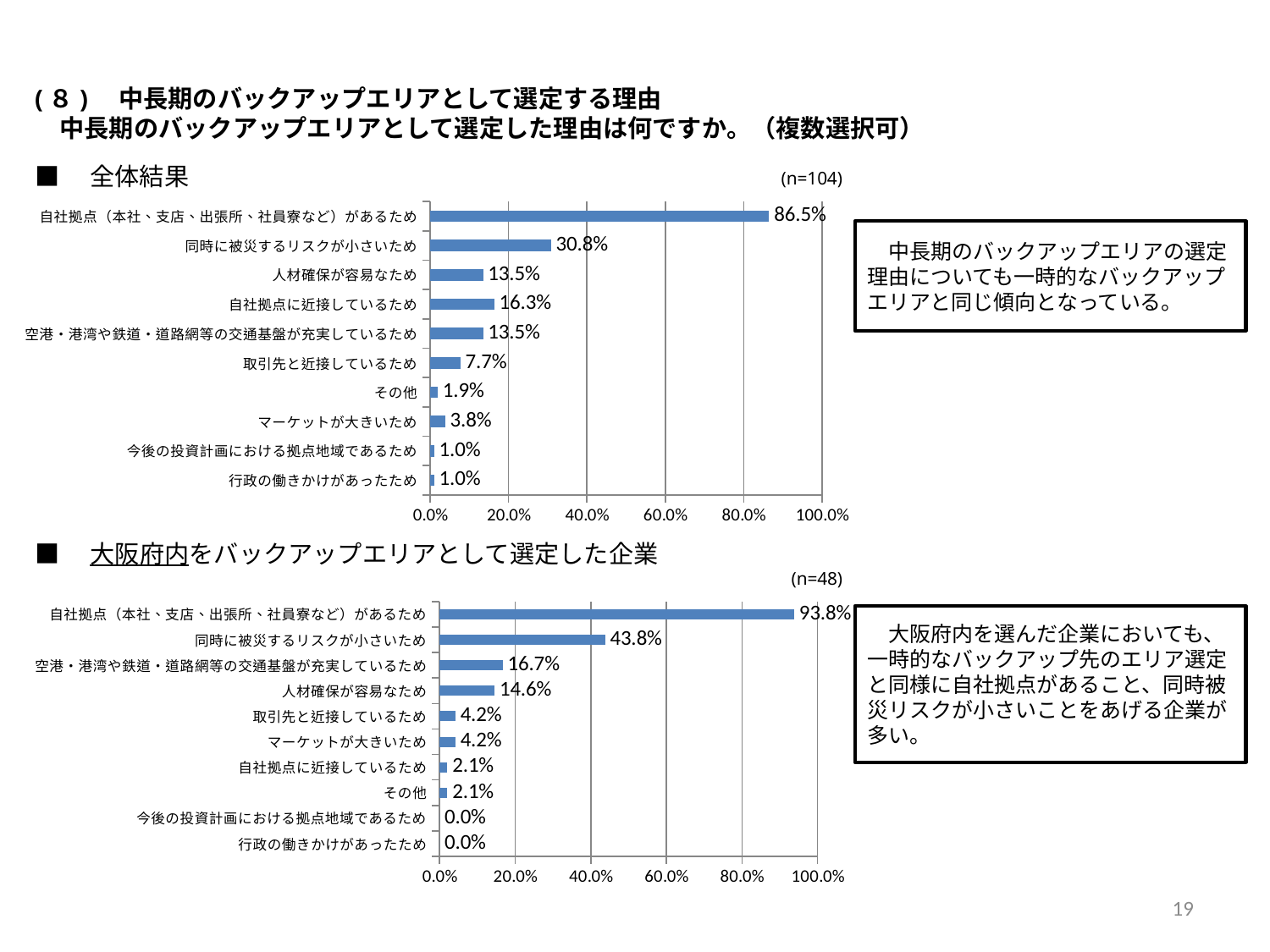
In the top chart (全体結果), how many categories are plotted? 10 In the bottom chart (大阪府内をバックアップエリアとして選定した企業), what is the value for 自社拠点（本社、支店、出張所、社員寮など）があるため? 93.8% In the top chart (全体結果), what is the value for 同時に被災するリスクが小さいため? 30.8% What type of chart is the top chart (全体結果)? Bar chart In the bottom chart (大阪府内をバックアップエリアとして選定した企業), what is the value for 空港・港湾や鉄道・道路網等の交通基盤が充実しているため? 16.7% What is the sample size (n) shown for the bottom chart (大阪府内をバックアップエリアとして選定した企業)? n=48 In the bottom chart (大阪府内をバックアップエリアとして選定した企業), what is the difference between 同時に被災するリスクが小さいため and 人材確保が容易なため? 29.2% In the bottom chart (大阪府内をバックアップエリアとして選定した企業), which category has the highest value? 自社拠点（本社、支店、出張所、社員寮など）があるため In the top chart (全体結果), what is the value for 自社拠点（本社、支店、出張所、社員寮など）があるため? 86.5% In the top chart (全体結果), which category has the lowest value? 今後の投資計画における拠点地域であるため and 行政の働きかけがあったため (both 1.0%) Which is larger: 同時に被災するリスクが小さいため in the top chart (全体結果) or in the bottom chart (大阪府内をバックアップエリアとして選定した企業)? The bottom chart (43.8%) In the top chart (全体結果), what is the difference between 自社拠点に近接しているため and 人材確保が容易なため? 2.8%